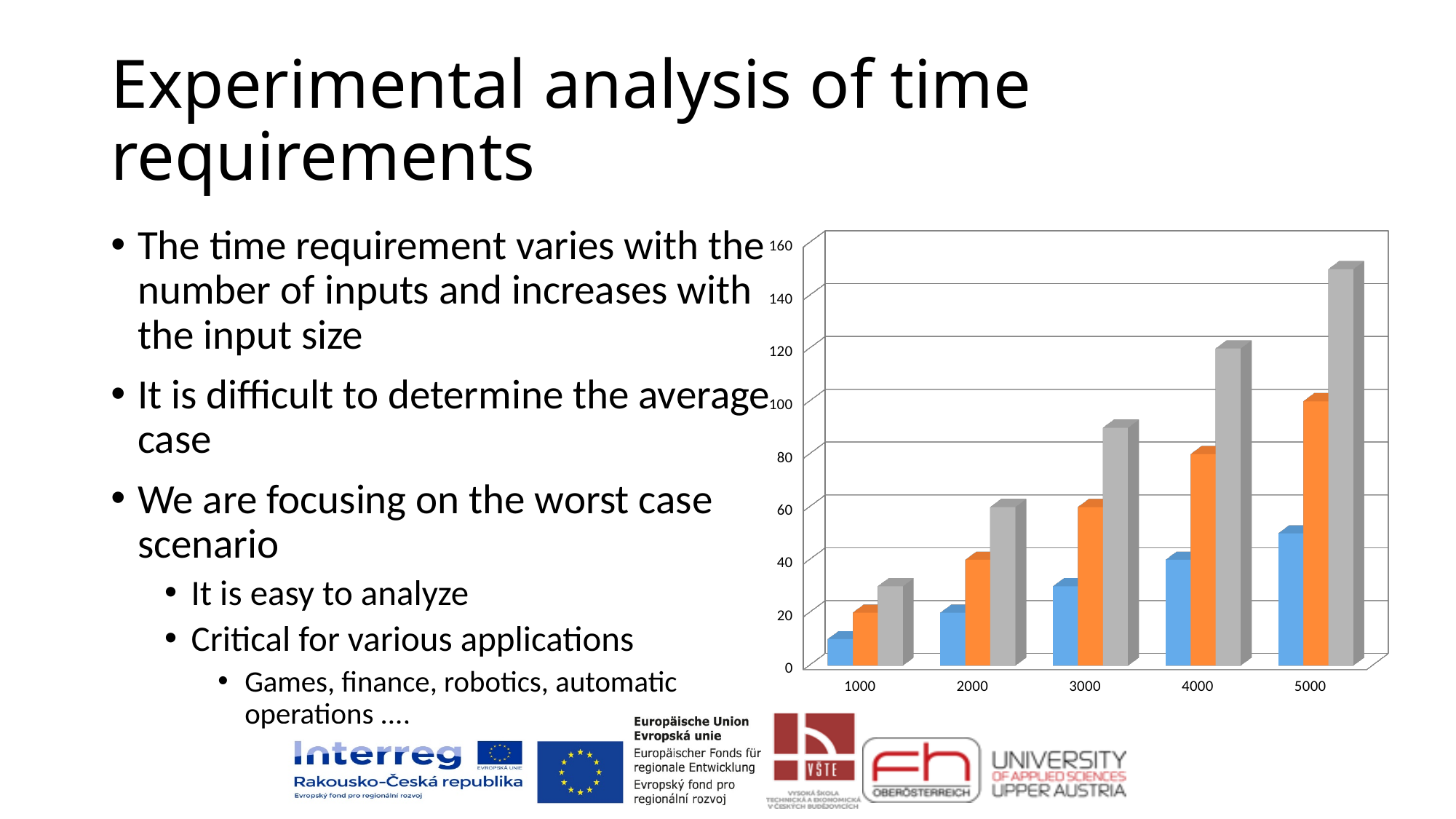
What is the highest value shown on the vertical axis of the chart? 160 Is the gray bar for 1000 greater or less than 40? less How many bars are shown for each category on the chart? 3 What kind of chart is shown on the slide? bar chart Is the orange bar for 3000 greater or less than 40? greater Do the gray bars rise or fall as the x axis goes from 1000 to 5000? rise How many categories are shown on the x axis of the chart? 5 Which category has the tallest gray bar on the chart? 5000 Which category has the shortest blue bar on the chart? 1000 Is the blue bar for 5000 greater or less than 60? less Which is larger at 4000: the orange bar or the blue bar? orange bar